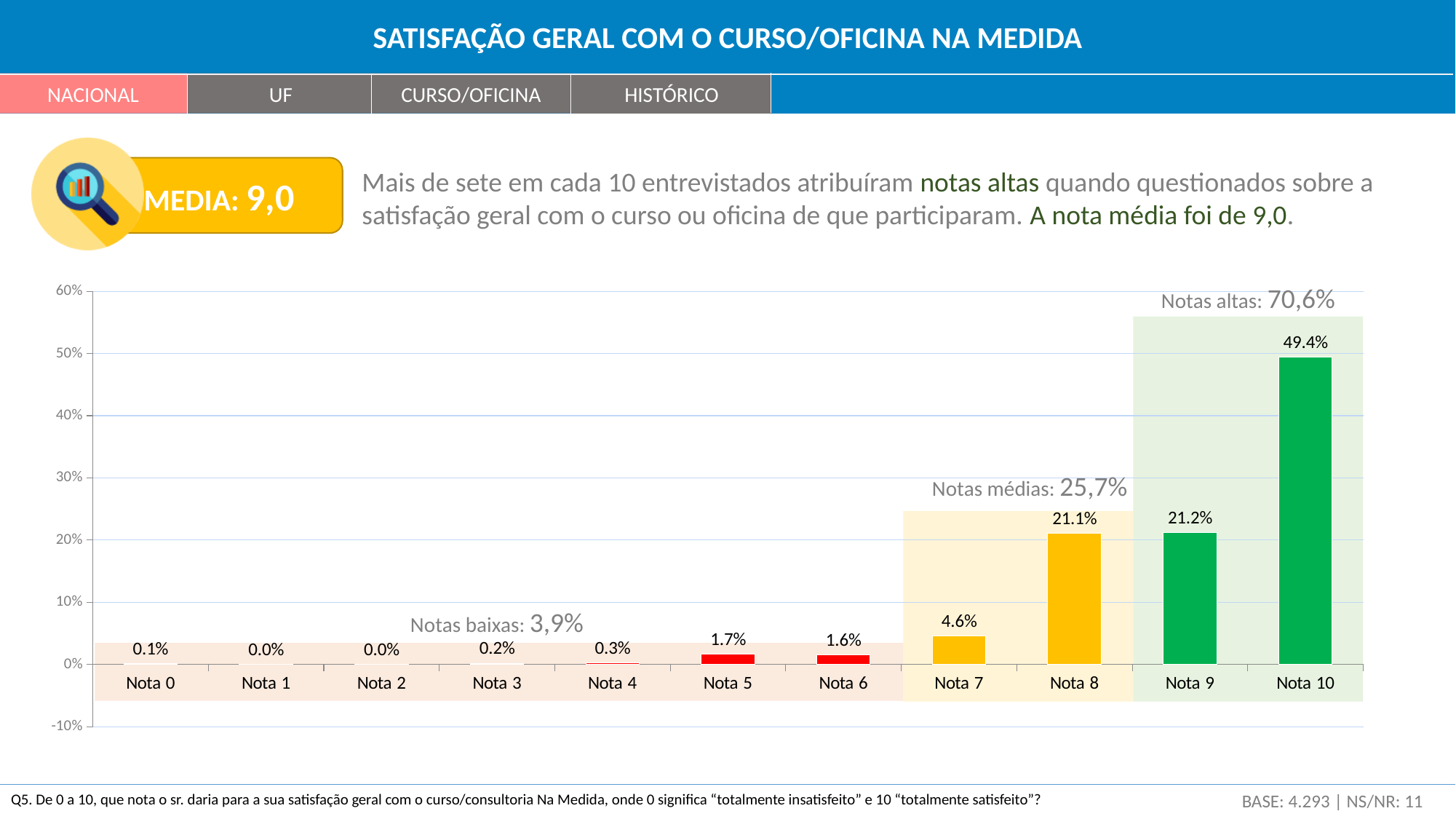
Which is larger, the value for Nota 7 or the value for Nota 6? Nota 7 What is the difference between the values for Nota 10 and Nota 9? 28.2% What is the value for Nota 4? 0.3% What kind of chart is shown on the slide? bar chart Is the value for Nota 10 greater or less than 40%? greater What is the value for Nota 5? 1.7% What percentage is labelled as 'Notas baixas' on the chart? 3,9% What is the value for Nota 8? 21.1% Which category has the highest value? Nota 10 What percentage is labelled as 'Notas altas' on the chart? 70,6% How many categories are shown on the x axis? 11 What is the value for Nota 10? 49.4%